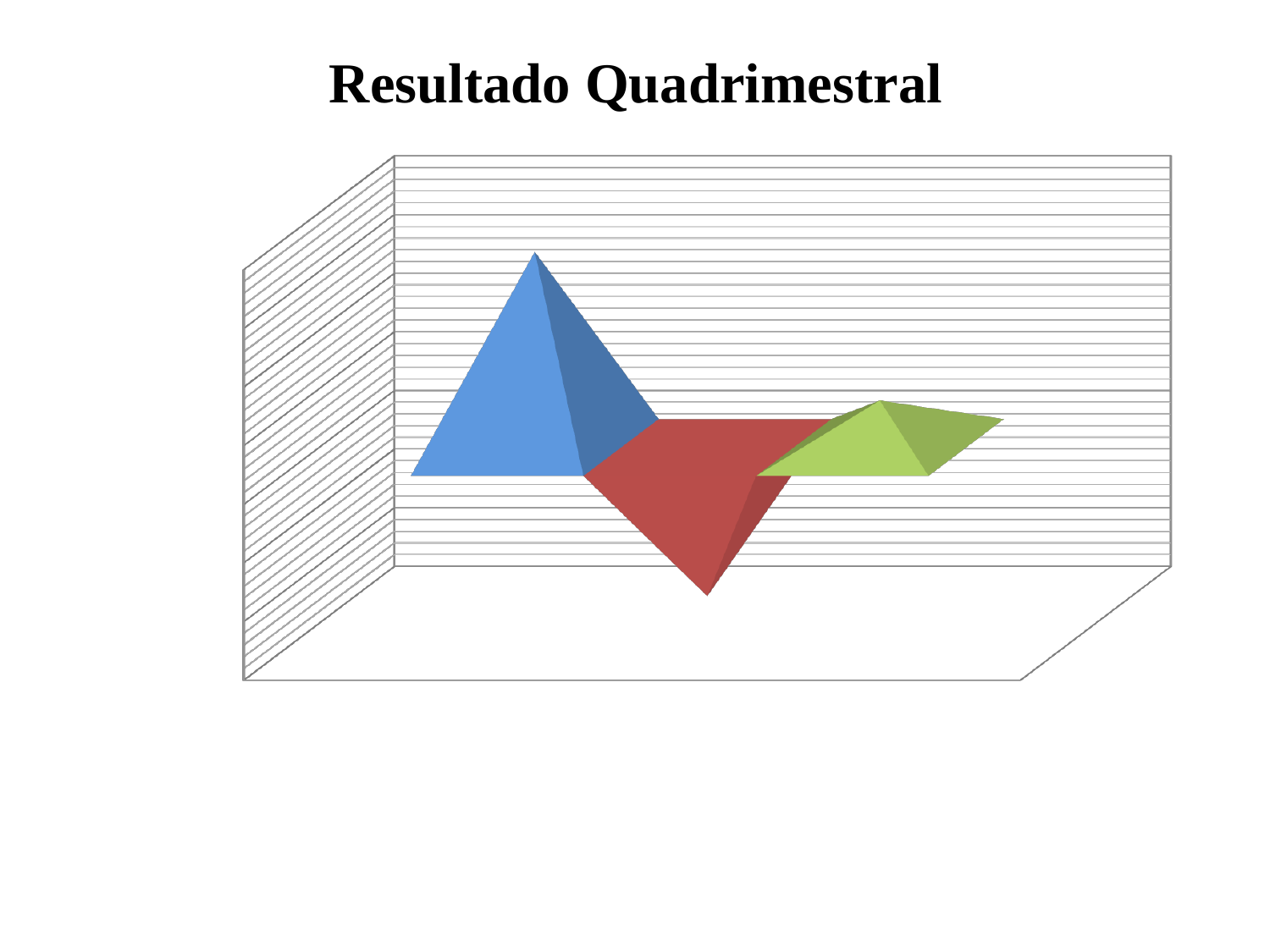
What kind of chart is shown on the slide? bar chart How many bars are plotted in the chart? 3 Which is larger, the value of the red bar or the value of the green bar? green What is the title of the chart on the slide? Resultado Quadrimestral Does the value rise or fall from the first (blue) bar to the second (red) bar? fall What colours are the three bars in the chart, from left to right? blue, red, green Which bar is the tallest in the chart: the blue, the red or the green one? blue Which bar has the lowest value in the chart: the blue, the red or the green one? red Does the value rise or fall from the second (red) bar to the third (green) bar? rise Which is larger, the value of the blue bar or the value of the green bar? blue